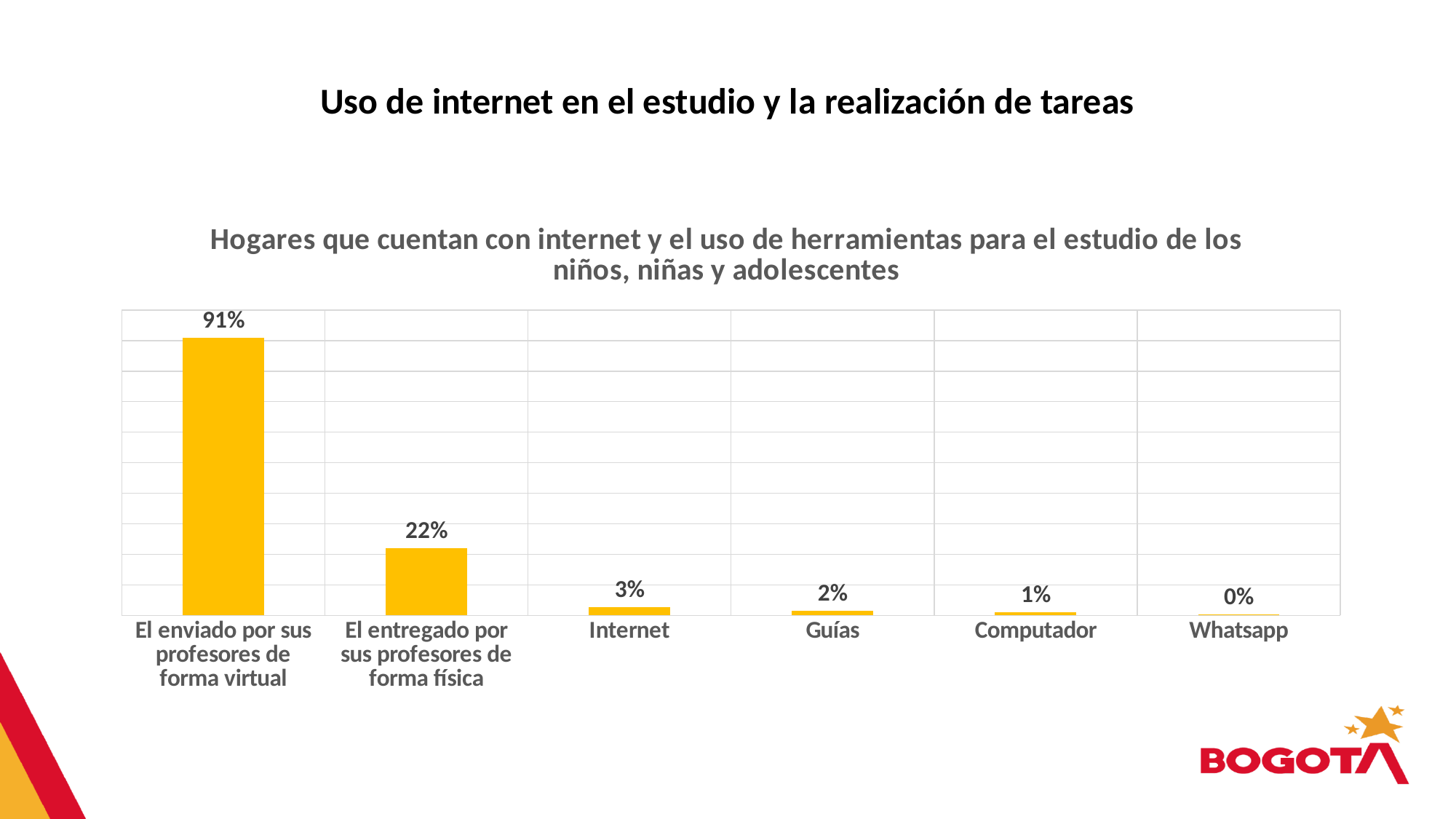
What is the difference between the values for 'El enviado por sus profesores de forma virtual' and 'El entregado por sus profesores de forma física'? 69% Which is larger, the value for 'Internet' or the value for 'Computador'? Internet How many categories are shown on the chart? 6 What kind of chart is shown on the slide? Bar chart Which category has the lowest value? Whatsapp Which category has the highest value? El enviado por sus profesores de forma virtual What is the title of the chart? Hogares que cuentan con internet y el uso de herramientas para el estudio de los niños, niñas y adolescentes What is the value for 'El entregado por sus profesores de forma física'? 22% What is the value for 'El enviado por sus profesores de forma virtual'? 91% What is the value for 'Internet'? 3% What is the value for 'Guías'? 2% What is the value for 'Whatsapp'? 0%